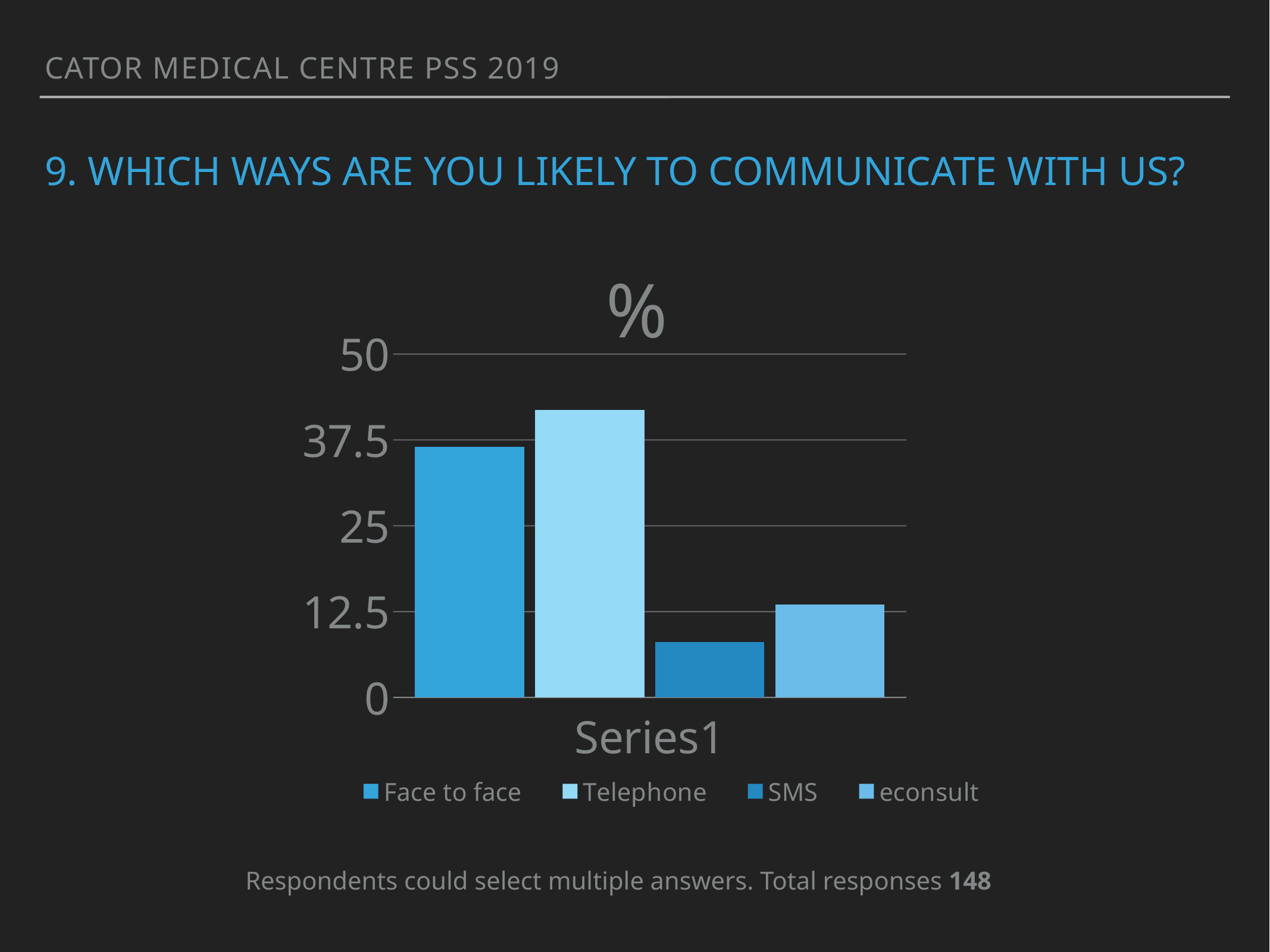
Which is larger, the value for Face to face or the value for SMS? Face to face What is the title of the chart? % Which is larger, the value for Telephone or the value for Face to face? Telephone Is the value for Face to face greater or less than 25? greater How many series does the legend list? 4 Is the value for Telephone greater or less than 50? less Which communication method has the highest bar? Telephone Which communication method has the lowest bar? SMS Is the value for Telephone greater or less than 37.5? greater Which is larger, the value for econsult or the value for SMS? econsult What kind of chart is shown on the slide? bar chart